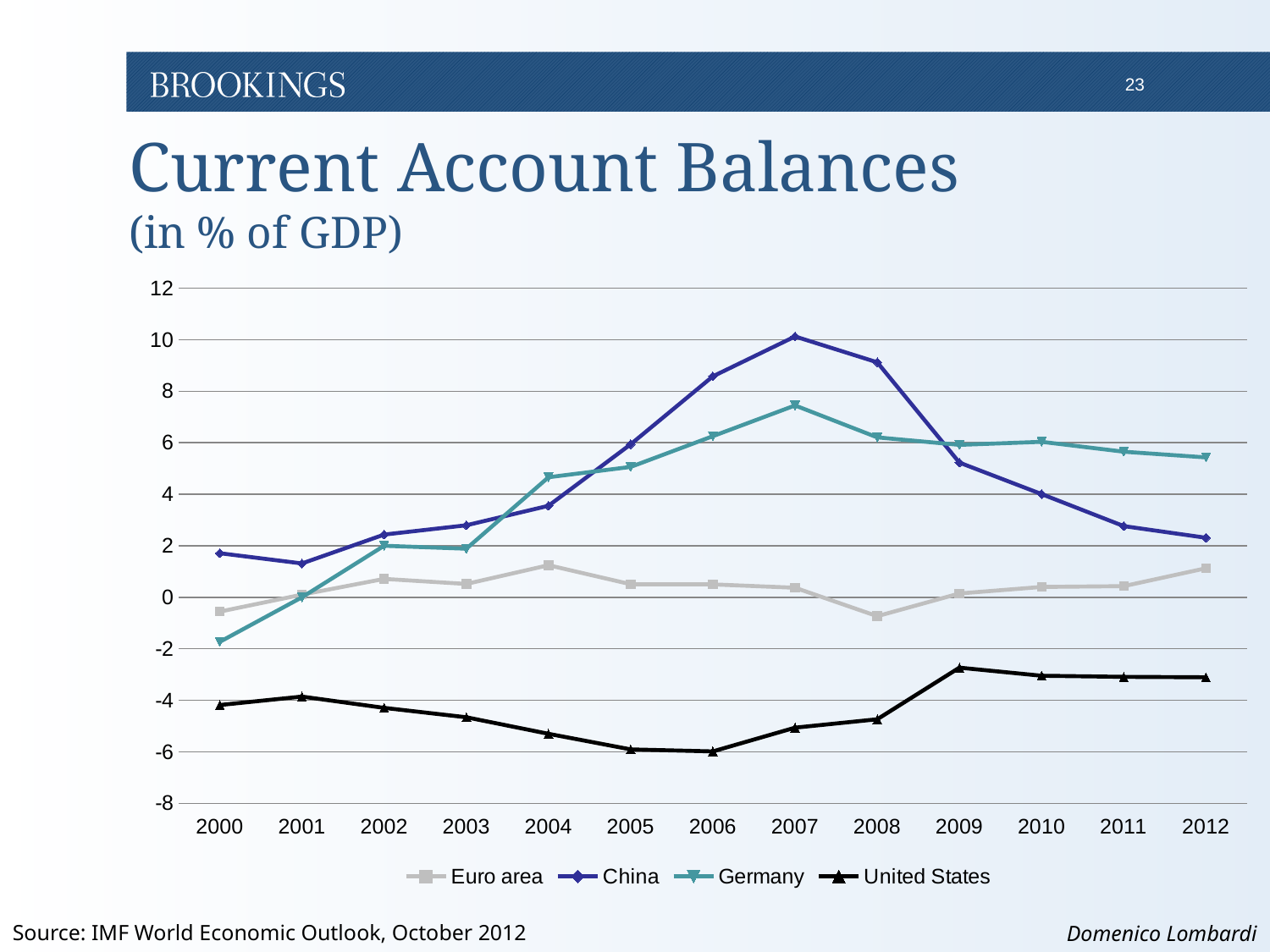
Is the value for the United States in 2005 greater or less than -4? less What is the title of the chart? Current Account Balances (in % of GDP) In 2012, which is higher, Germany or China? Germany Is the value for the Euro area in 2008 greater or less than 0? less In which year does China reach its peak value? 2007 How many years are shown along the x axis? 13 Which series has the lowest value in 2006? United States Is the value for China in 2007 greater or less than 8? greater What kind of chart is shown on the slide? line chart Which series has the highest value in 2007? China Does China's value rise or fall from 2007 to 2012? fall How many series does the legend list? 4